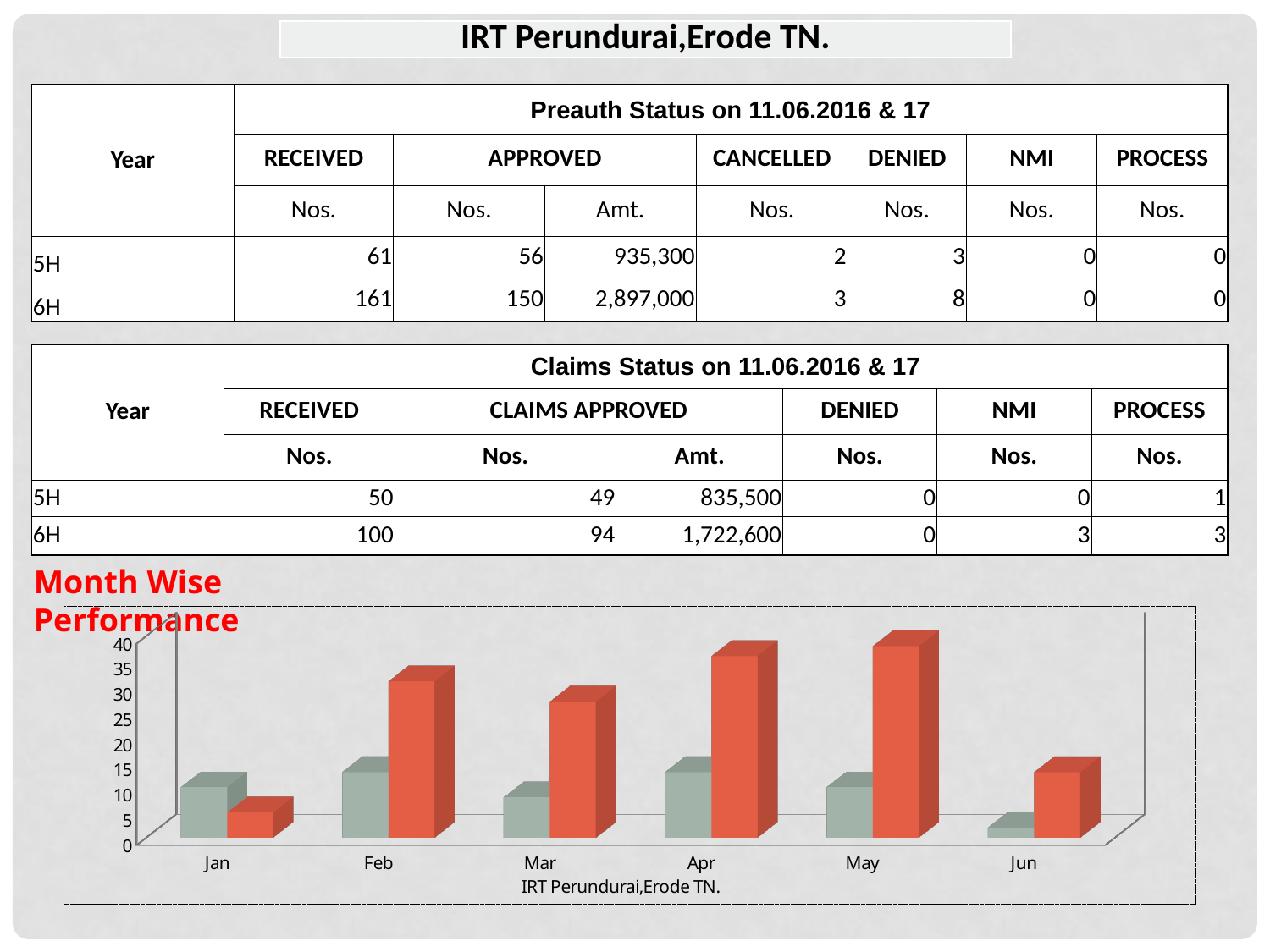
In the bar chart, which month has the lowest value for the red series? Jan What kind of chart is shown under the heading "Month Wise Performance"? bar chart In the bar chart, is the red bar for Jan greater or less than 10? less What text appears as the axis title below the months in the bar chart? IRT Perundurai,Erode TN. In the bar chart, is the grey bar for Jun greater or less than 5? less In the bar chart, does the red series rise or fall from Jan to Feb? rise In the bar chart, which month has the lowest value for the grey series? Jun How many months are shown on the x axis of the bar chart? 6 In the bar chart, is the red bar for Mar greater or less than 20? greater In the bar chart, which is larger for Feb: the grey bar or the red bar? the red bar In the bar chart, which is larger for Jan: the grey bar or the red bar? the grey bar